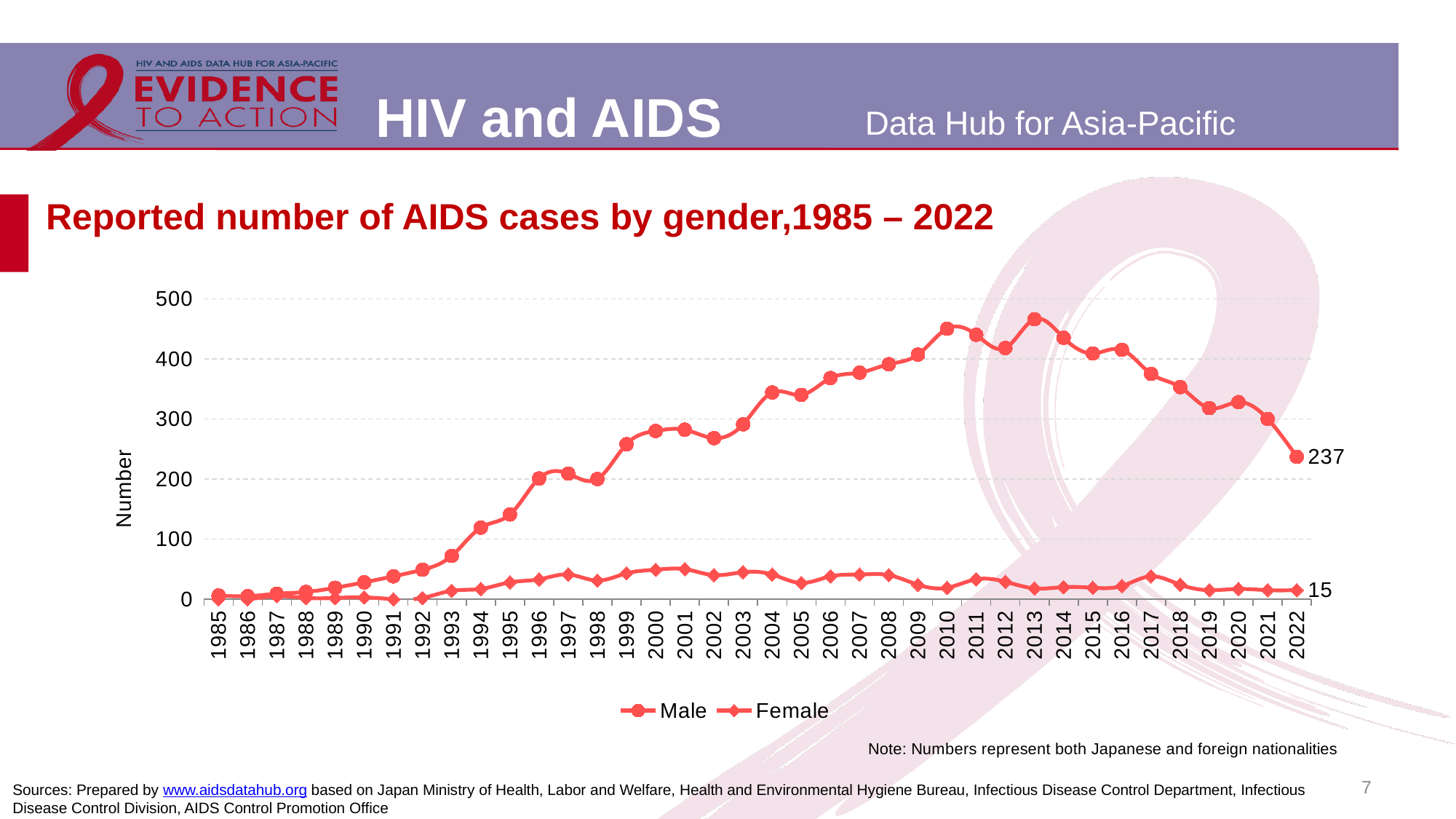
How many years are shown on the x axis? 38 In 2022, which series has the larger value, Male or Female? Male What is the reported number of AIDS cases for Female in 2022? 15 What is the reported number of AIDS cases for Male in 2022? 237 What is the difference between the Male and Female values in 2022? 222 Is the Female value for 2001 greater or less than 100? less Does the Male series rise or fall between 2013 and 2022? Fall How many series does the legend list? 2 What kind of chart is shown on the slide? Line chart In which year does the Male series reach its highest value? 2013 Is the Male value for 2000 greater or less than 200? greater Is the Male value for 2013 greater or less than 400? greater